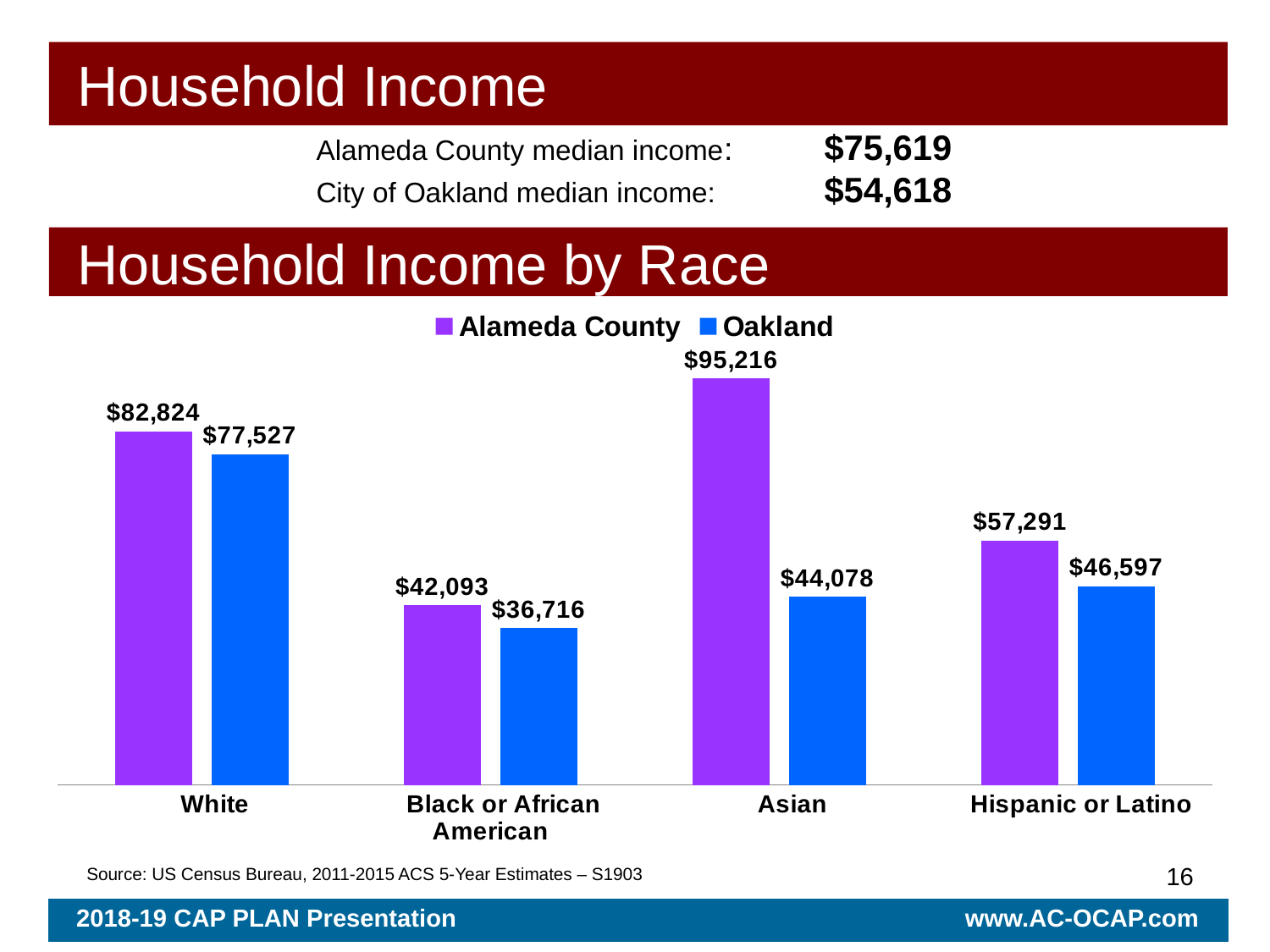
How many race categories are shown on the x axis of the Household Income by Race chart? 4 What is the Oakland household income for Hispanic or Latino households? $46,597 What is the Alameda County household income for Asian households in the Household Income by Race chart? $95,216 Which is larger: the Oakland household income for Asian households or for Hispanic or Latino households? Hispanic or Latino What is the difference between the Alameda County and Oakland household incomes for Asian households? $51,138 What is the Oakland household income for Black or African American households? $36,716 Which race category has the highest Alameda County household income? Asian What type of chart is the Household Income by Race chart? Bar chart Which race category has the highest Oakland household income? White Which race category has the lowest Oakland household income? Black or African American How many series does the legend of the Household Income by Race chart list? 2 What is the difference between the Alameda County and Oakland household incomes for Hispanic or Latino households? $10,694